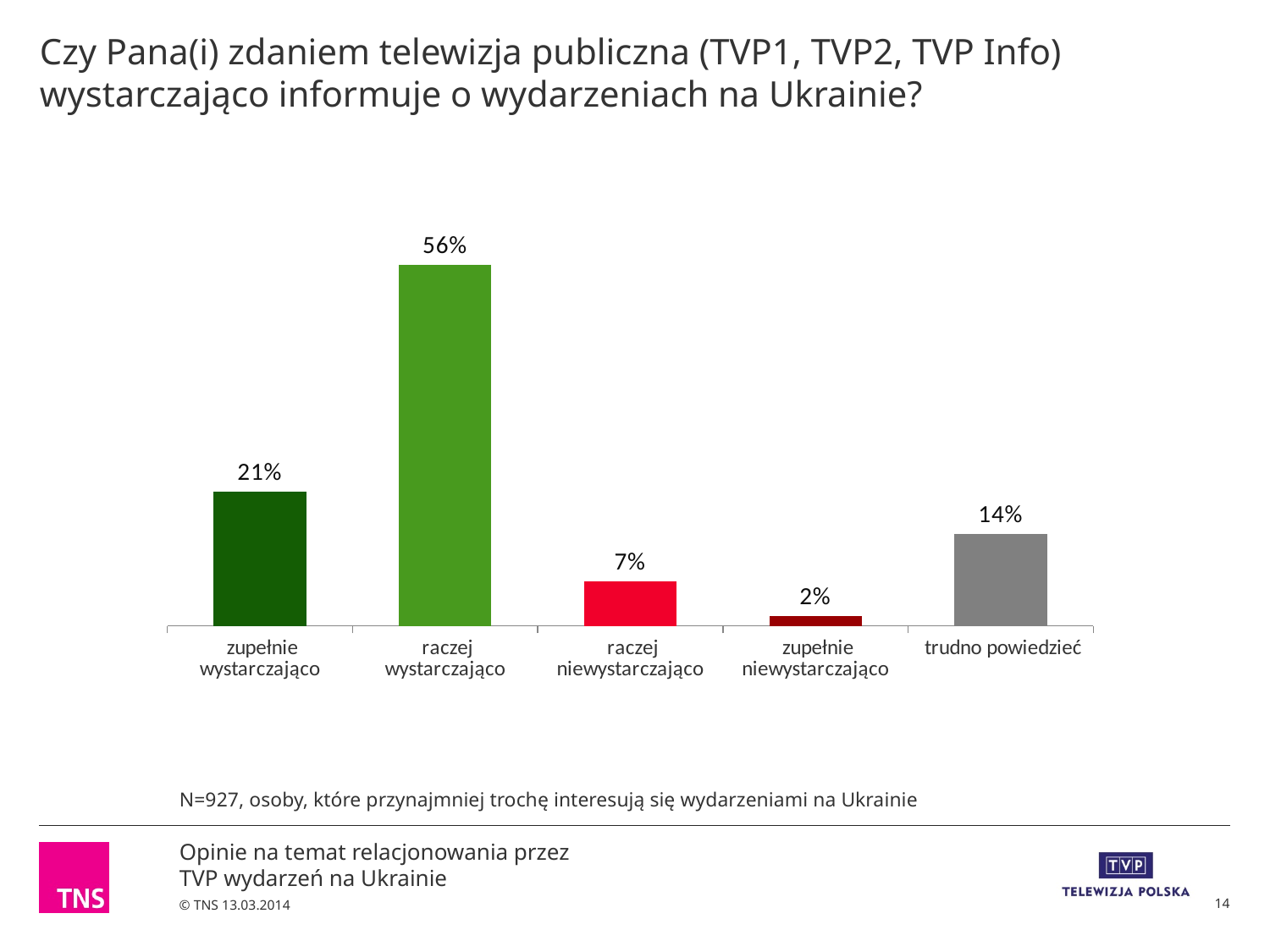
How many response categories are shown on the chart? 5 What is the difference between the values for "raczej wystarczająco" and "zupełnie wystarczająco"? 35 percentage points What percentage of respondents answered "raczej wystarczająco"? 56% Which response category has the lowest value? zupełnie niewystarczająco What percentage is shown for "trudno powiedzieć"? 14% Which response category has the highest value? raczej wystarczająco Which is larger: the value for "trudno powiedzieć" or for "raczej niewystarczająco"? trudno powiedzieć What is the value shown for "zupełnie wystarczająco"? 21% What type of chart is shown on the slide? bar chart What is the value for "zupełnie niewystarczająco"? 2% What is the sample size (N) stated below the chart? N=927 What is the difference between "raczej niewystarczająco" and "zupełnie niewystarczająco"? 5 percentage points